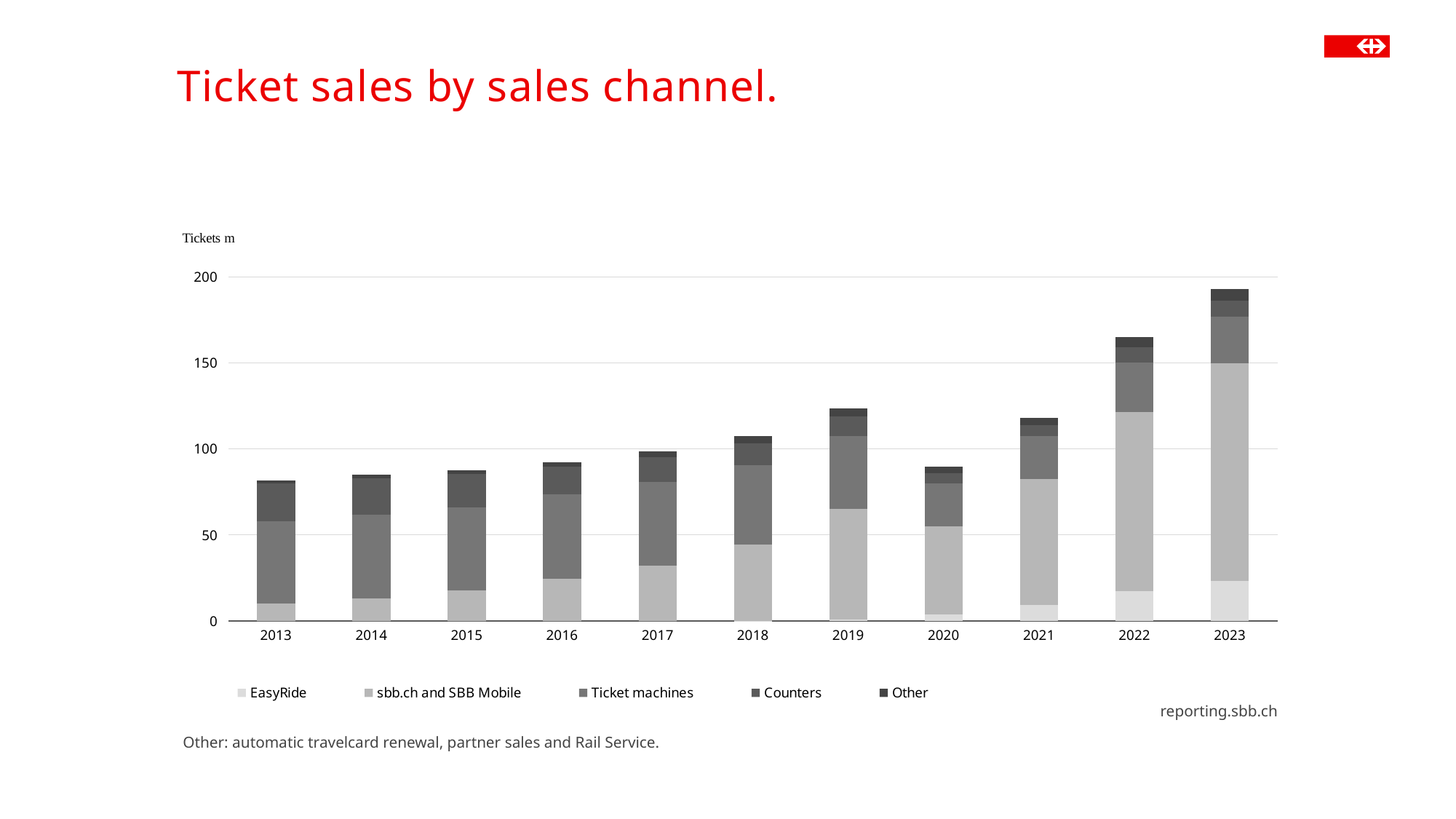
What kind of chart is shown on the slide? Stacked bar chart Do total ticket sales rise or fall from 2013 to 2019? rise What unit is shown on the y axis of the chart? Tickets m How many series does the legend list? 5 How many years are shown on the x axis? 11 Is the total ticket sales value for 2020 greater or less than 100? less Is the total ticket sales value for 2013 greater or less than 100? less Which year has the larger total ticket sales, 2021 or 2022? 2022 Which year has the highest total ticket sales? 2023 Which year has the larger total ticket sales, 2019 or 2020? 2019 Is the total ticket sales value for 2019 greater or less than 100? greater